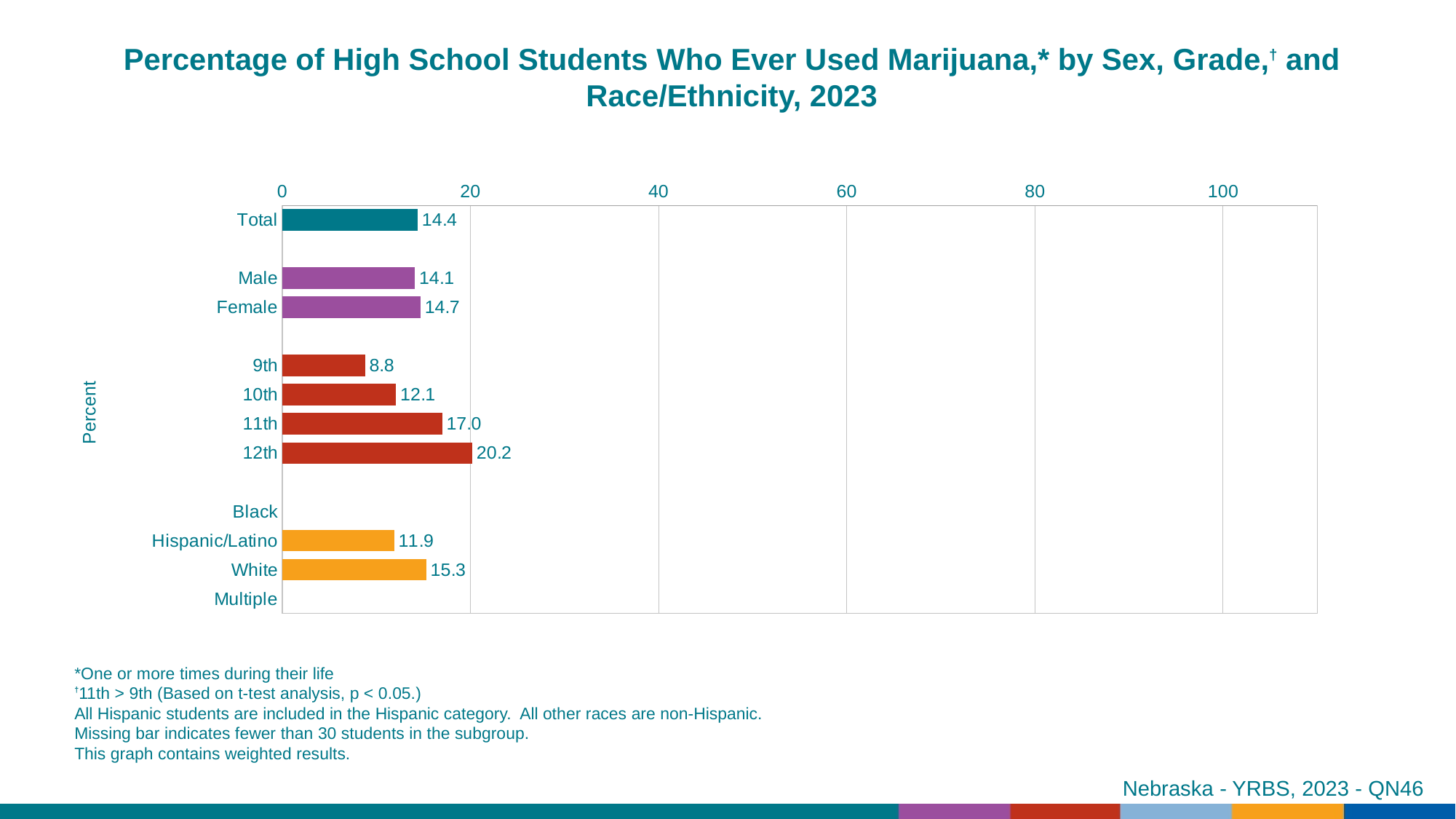
Which race/ethnicity categories have no bar shown? Black and Multiple Do the values rise or fall from 9th grade to 12th grade? rise What kind of chart is shown on the slide? bar chart What is the value for Total? 14.4 Which category has the highest value on the chart? 12th Is the value for 12th grade greater or less than 20? greater What is the difference between the values for White and Hispanic/Latino? 3.4 What is the value for Hispanic/Latino? 11.9 What is the difference between the values for 12th and 9th grade? 11.4 What is the value for 12th grade? 20.2 Which is larger, the value for Male or the value for Female? Female Which grade has the lowest value? 9th